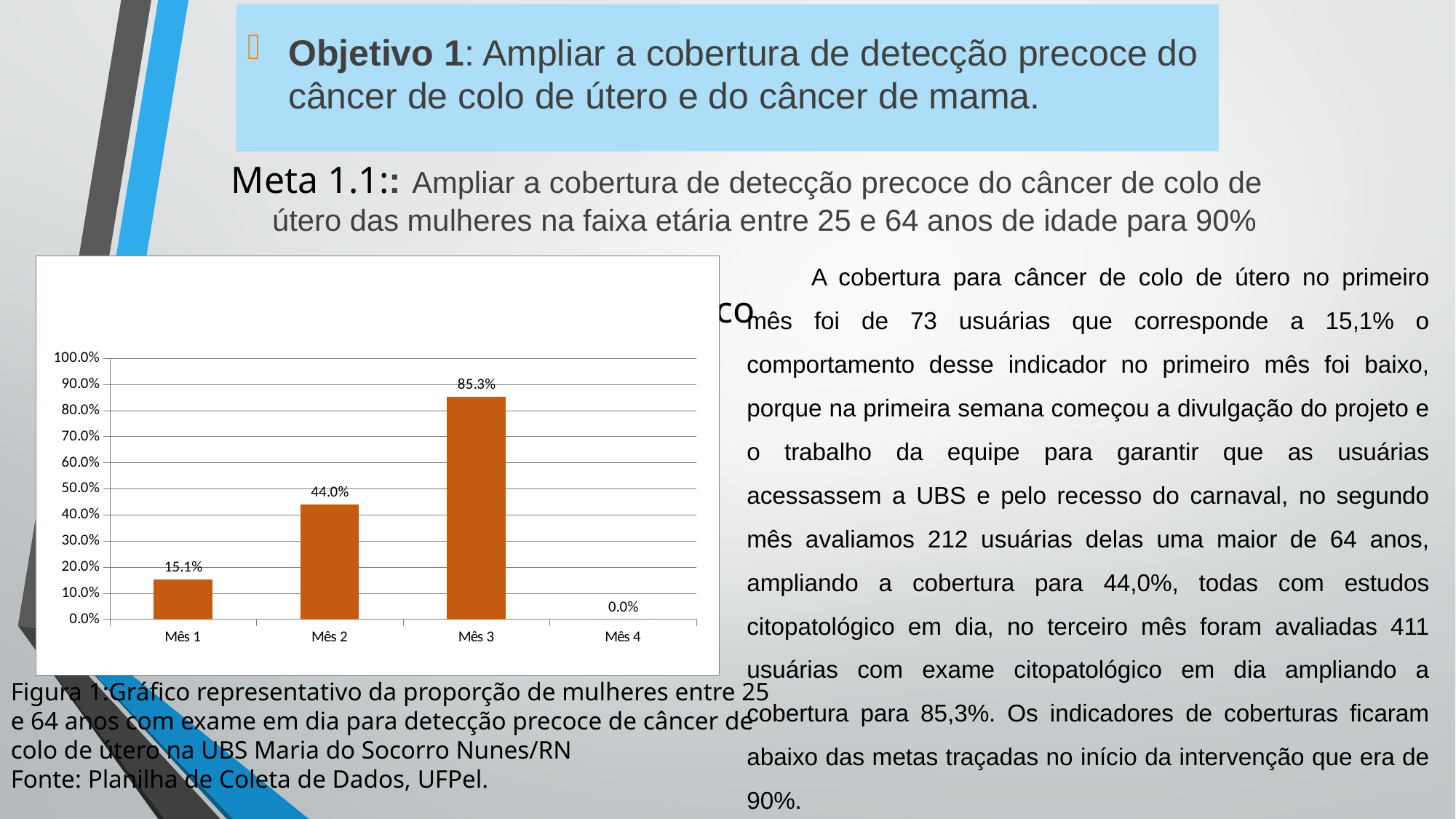
What is the value for Mês 3? 85.3% What is the value for Mês 2? 44.0% Which month has the highest value? Mês 3 Which is larger, the value for Mês 1 or the value for Mês 2? Mês 2 What is the value for Mês 4? 0.0% What kind of chart is shown on the slide? bar chart Is the value for Mês 3 greater or less than 80.0%? greater Which month has the lowest value? Mês 4 How many months are shown on the x axis? 4 What is the difference between the values for Mês 3 and Mês 2? 41.3% What is the value for Mês 1? 15.1% What is the difference between the values for Mês 2 and Mês 1? 28.9%